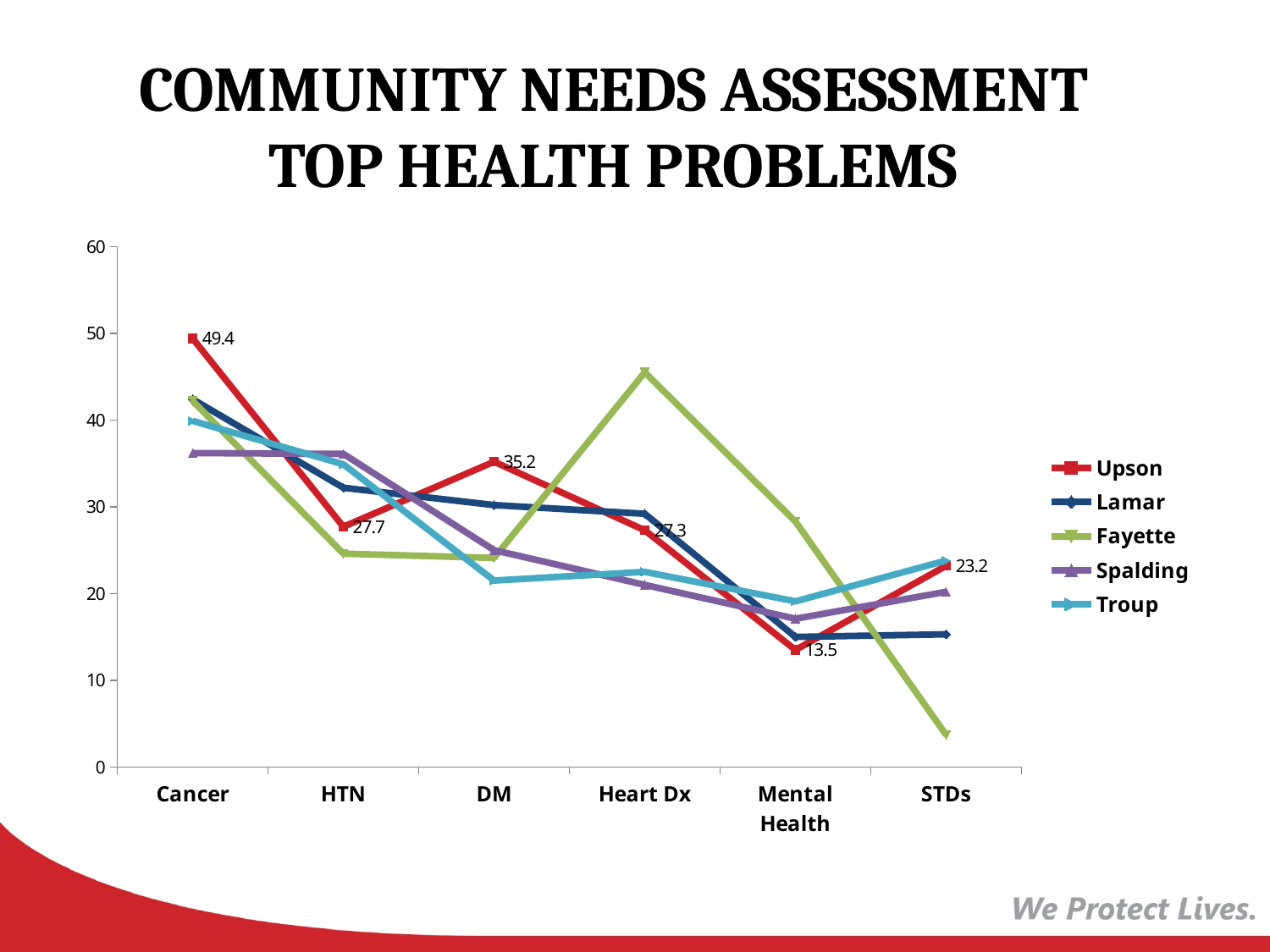
How many health problem categories are shown on the x axis? 6 For which category is the Upson value highest? Cancer What is the difference between the Upson values for Cancer and Mental Health? 35.9 How many series does the legend list? 5 What is the value for Upson for Cancer? 49.4 What is the value for Upson for STDs? 23.2 For which category is the Upson value lowest? Mental Health Is the value for Fayette for Heart Dx greater or less than 40? greater What kind of chart is shown on the slide? line chart What is the value for Upson for DM? 35.2 What is the value for Upson for Mental Health? 13.5 Is the value for Fayette for STDs greater or less than 10? less